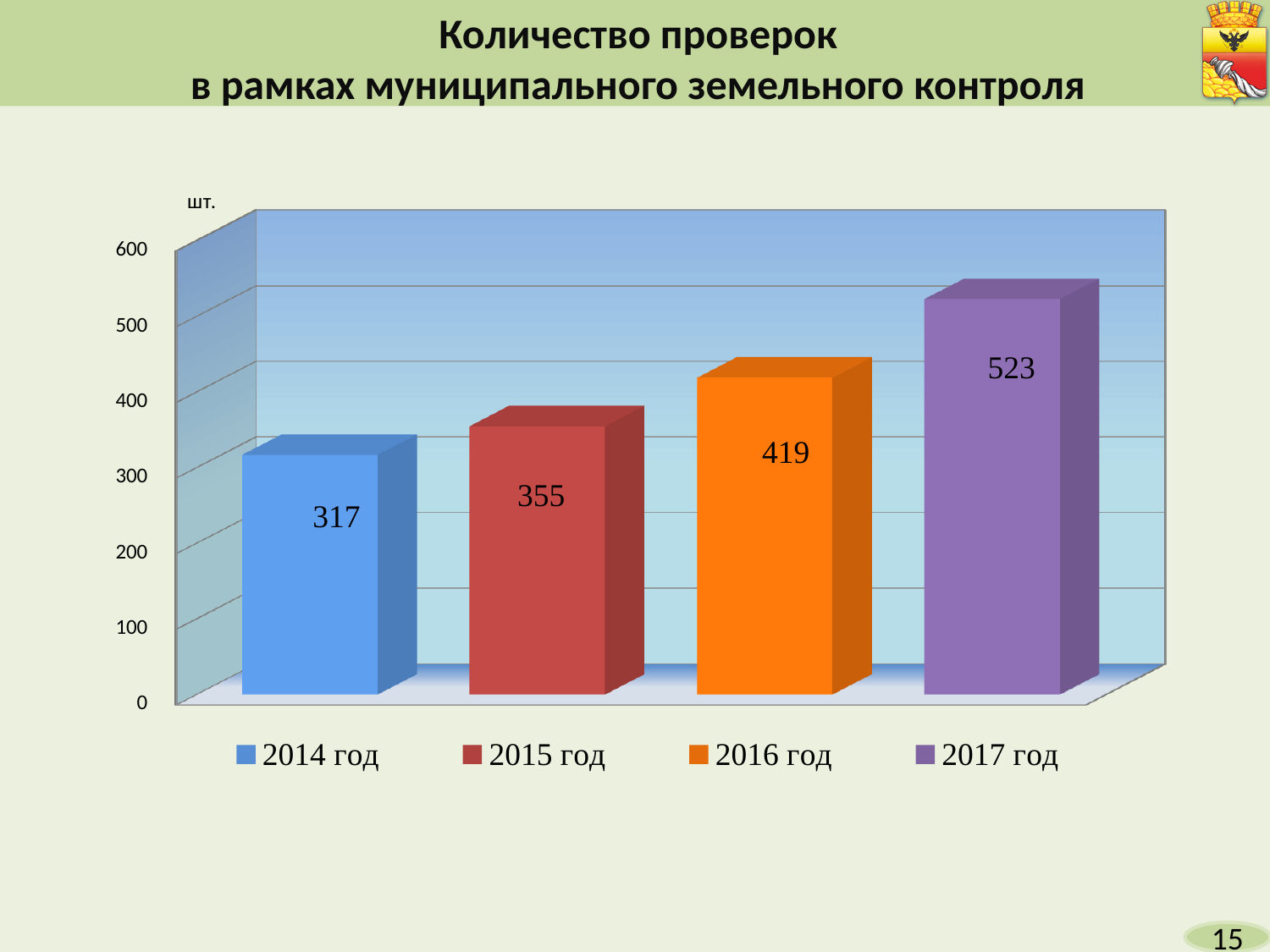
What is the value for 2016 год? 419 Do the values rise or fall from 2014 год to 2017 год? rise Which is larger, the value for 2015 год or the value for 2016 год? 2016 год Is the value for 2017 год greater or less than 500? greater What is the difference between the values for 2017 год and 2014 год? 206 How many bars are shown in the chart? 4 Which year has the highest number of inspections? 2017 год Which year has the lowest number of inspections? 2014 год What kind of chart is shown on the slide? bar chart What is the value for 2014 год? 317 What is the difference between the values for 2016 год and 2015 год? 64 What is the value for 2017 год? 523